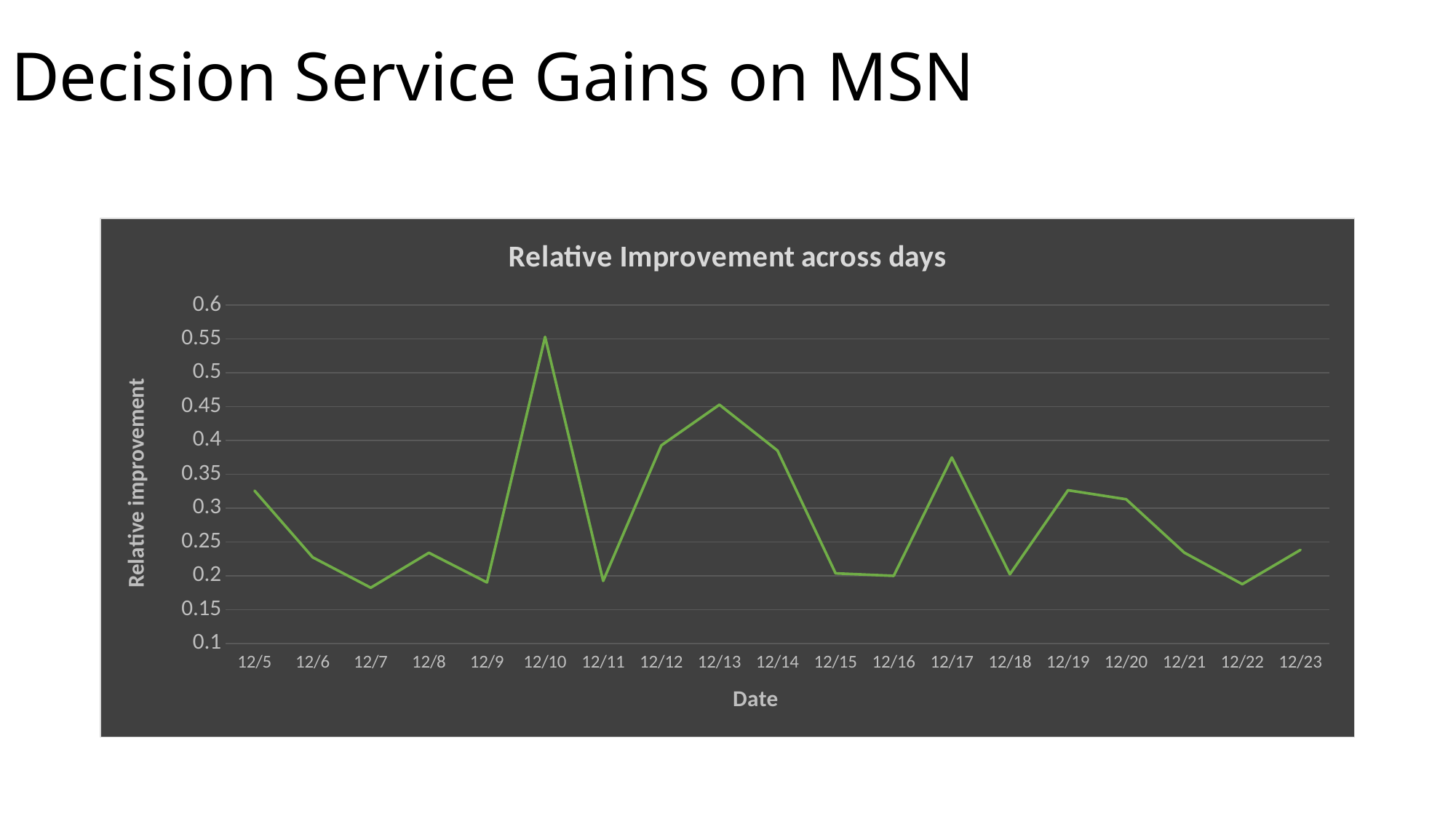
On which date is the relative improvement highest? 12/10 What kind of chart is shown on the slide? line chart What is the label of the vertical axis? Relative improvement Is the value for 12/21 greater or less than 0.25? less Is the value for 12/10 greater or less than 0.5? greater Which date has the larger value, 12/17 or 12/18? 12/17 Is the value for 12/13 greater or less than 0.4? greater What is the title of the chart? Relative Improvement across days How many dates are plotted along the x axis? 19 Which date has the larger value, 12/10 or 12/13? 12/10 Does the relative improvement rise or fall from 12/13 to 12/15? fall